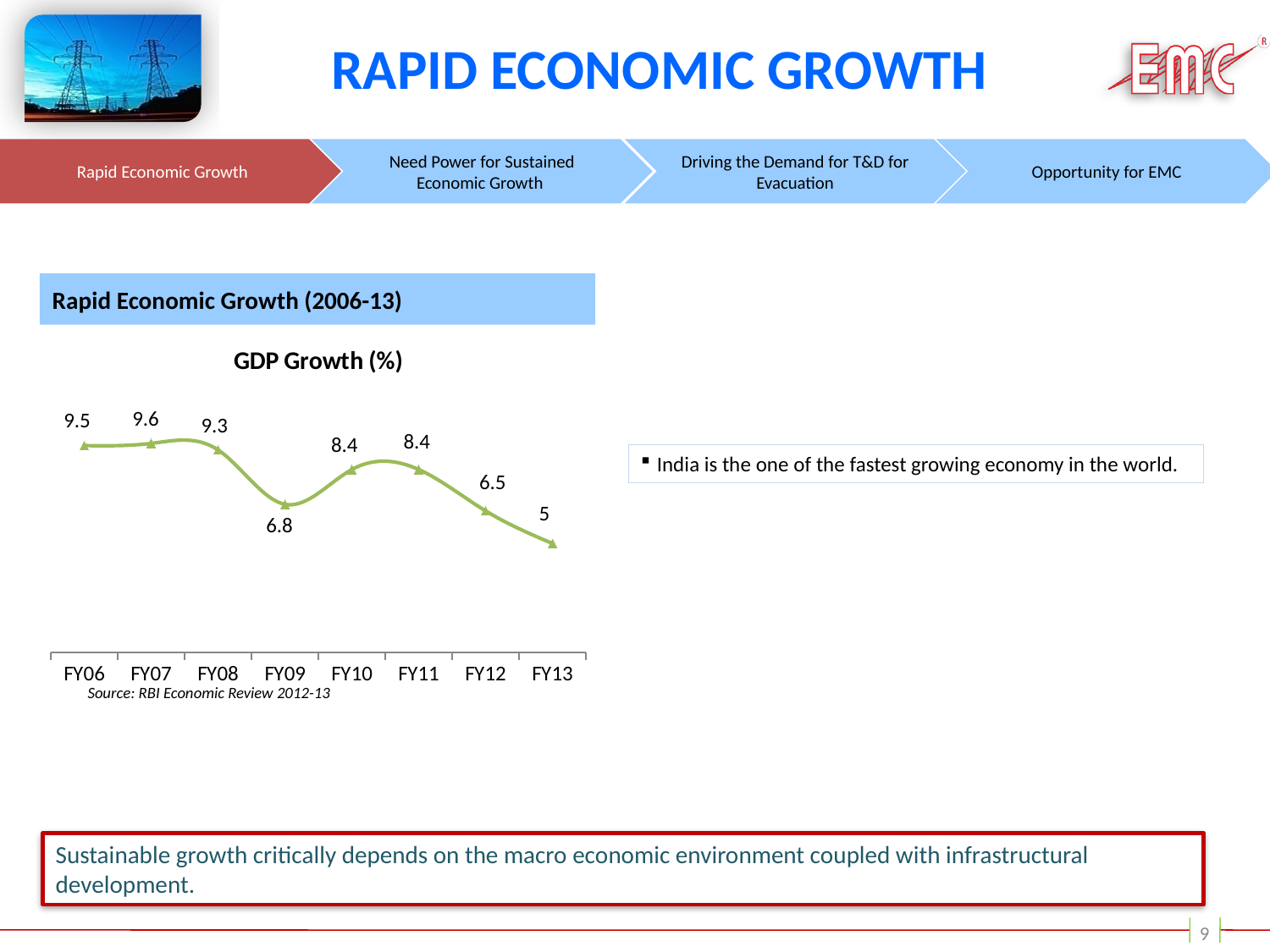
What is the GDP growth value for FY13? 5 Which fiscal year has the highest GDP growth? FY07 What is the difference in GDP growth between FY07 and FY13? 4.6 Which has a higher GDP growth value, FY10 or FY12? FY10 What is the GDP growth value for FY06? 9.5 What is the GDP growth value for FY09? 6.8 What kind of chart is used to show GDP growth? Line chart Does GDP growth rise or fall from FY11 to FY13? Fall How many fiscal years are plotted on the chart? 8 What is the title of the chart? GDP Growth (%) Which fiscal year has the lowest GDP growth? FY13 What is the difference in GDP growth between FY08 and FY09? 2.5